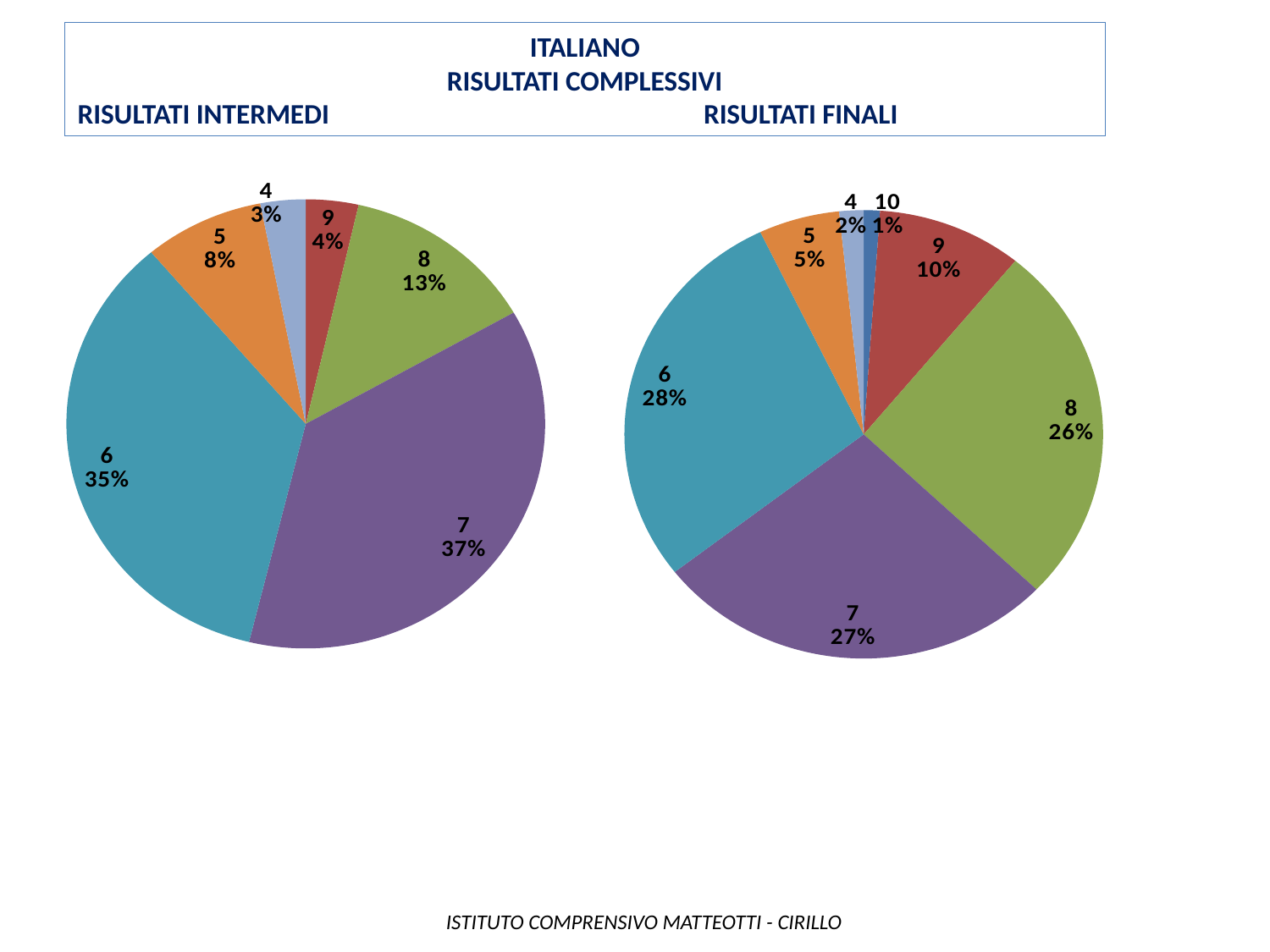
In the RISULTATI FINALI pie chart, what share does grade 8 have? 26% In the RISULTATI INTERMEDI pie chart, which grade has the largest share? 7 In the RISULTATI FINALI pie chart, what share does grade 10 have? 1% What type of chart is used for RISULTATI FINALI? Pie chart In the RISULTATI INTERMEDI pie chart, what share does grade 7 have? 37% How many slices does the RISULTATI FINALI pie chart have? 7 In the RISULTATI FINALI pie chart, which grade has the smallest share? 10 In the RISULTATI INTERMEDI pie chart, which grade has the smallest share? 4 In the RISULTATI FINALI pie chart, what is the difference between the shares of grade 6 and grade 9? 18% In the RISULTATI INTERMEDI pie chart, which has the larger share, grade 8 or grade 5? 8 How many slices does the RISULTATI INTERMEDI pie chart have? 6